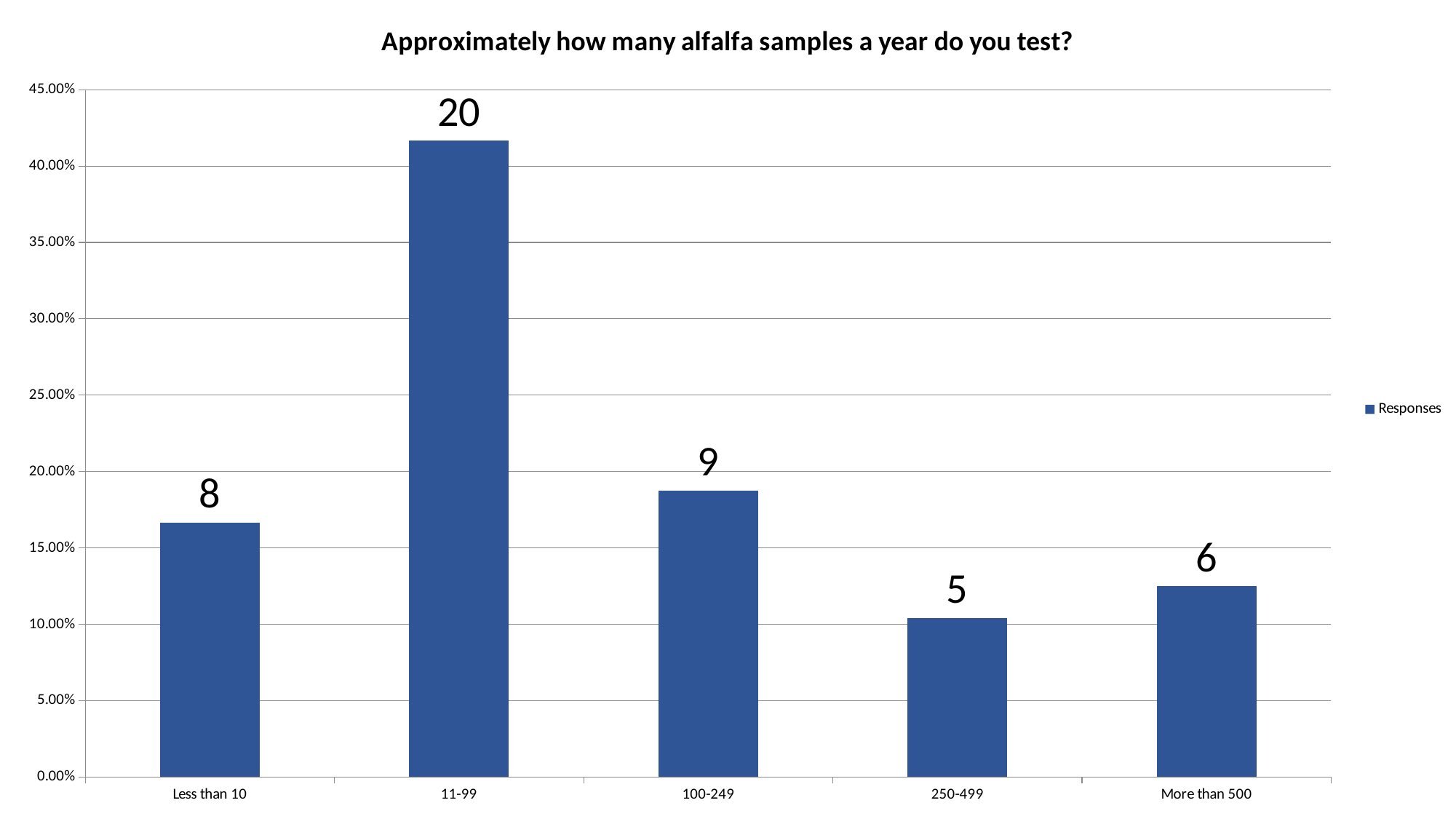
How many series does the legend list? 1 How many categories are shown on the x axis? 5 Which category has the lowest bar? 250-499 What is the data label shown on the bar for 250-499? 5 Which category has the highest bar? 11-99 What is the difference between the data labels for 11-99 and 100-249? 11 Is the percentage value for 11-99 greater or less than 40.00%? greater What is the data label shown on the bar for More than 500? 6 Which bar is taller, Less than 10 or 100-249? 100-249 What is the title of the chart? Approximately how many alfalfa samples a year do you test? What type of chart is shown on the slide? bar chart What is the data label shown on the bar for 11-99? 20